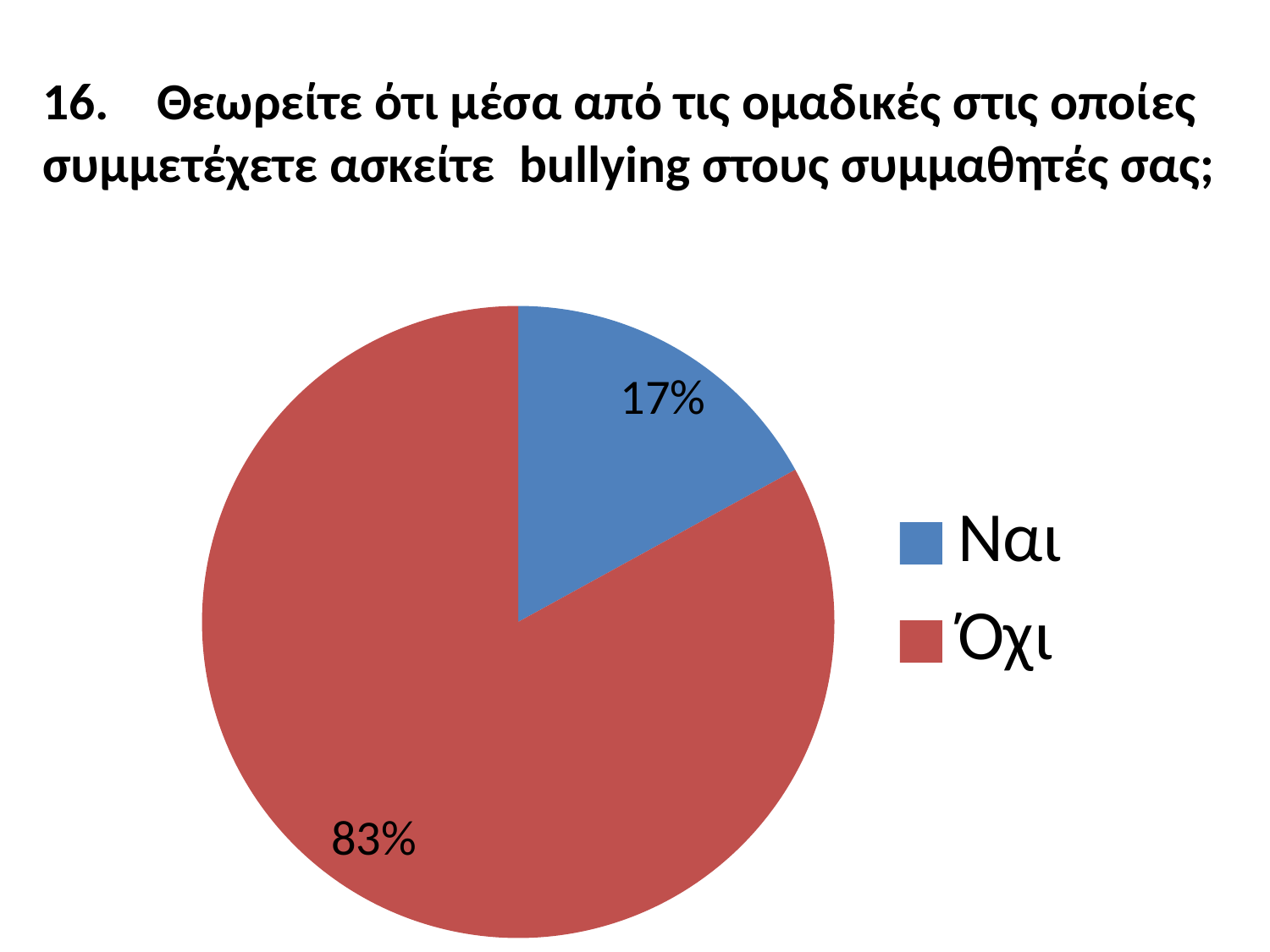
Which category has the smallest share of the pie? Ναι What share of the pie does the Ναι slice represent? 17% What is the difference in percentage points between Όχι and Ναι? 66 Which is larger, the share for Ναι or the share for Όχι? Όχι Which category has the largest share of the pie? Όχι What percentage is shown for Ναι? 17% What colour is the Ναι slice? blue What colour is the Όχι slice? red What percentage is shown for Όχι? 83% How many entries does the legend list? 2 How many slices does the pie chart have? 2 What kind of chart is shown on the slide? pie chart